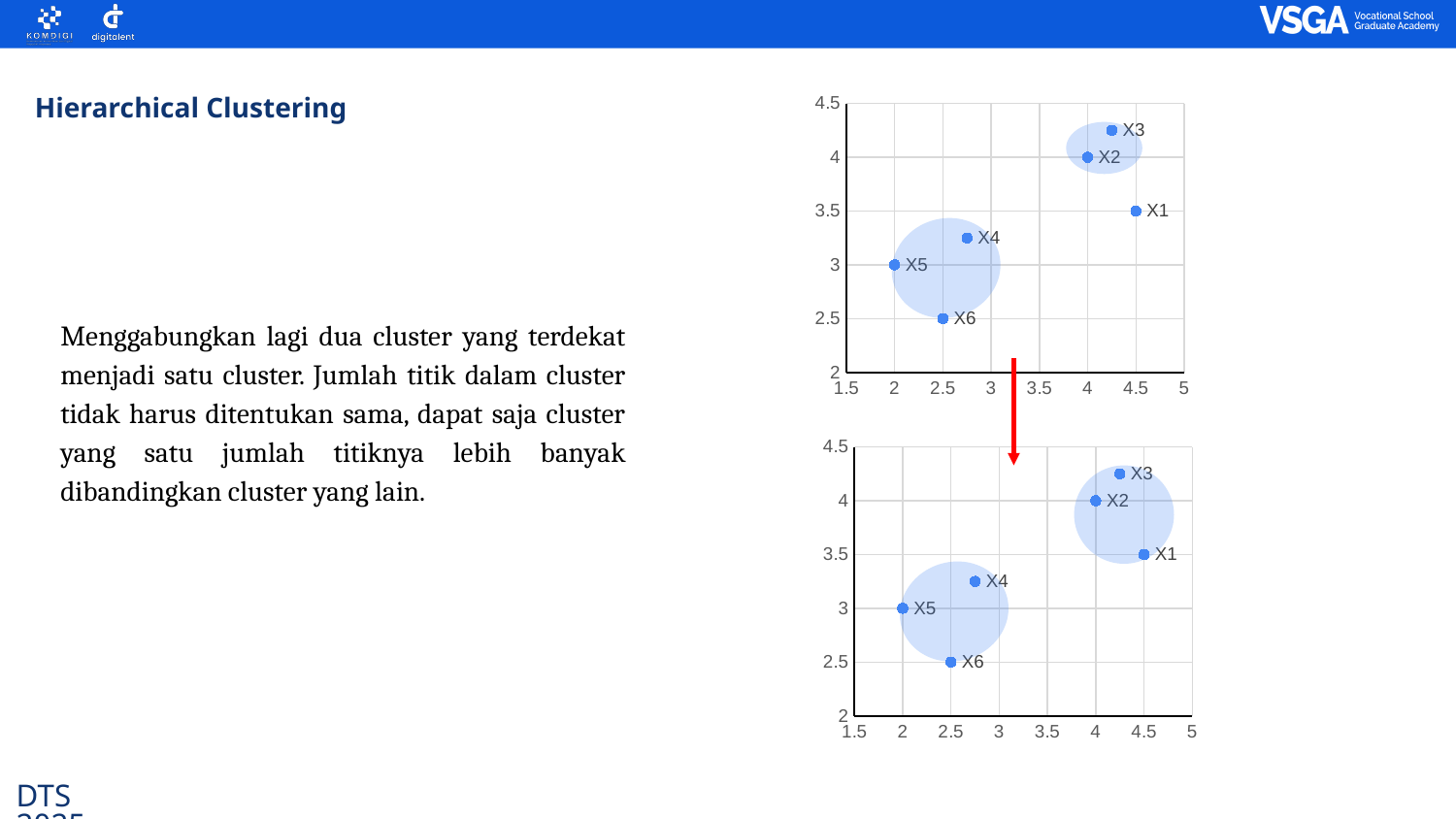
In the top chart, which point has the highest y-value? X3 In the bottom chart, which point has the lowest y-value? X6 What kind of chart is the top chart on the slide? scatter chart In the top chart, which point has a larger y-value, X1 or X2? X2 In the top chart, which point has the smallest x-value? X5 In the top chart, what is the y-value of point X5? 3 In the bottom chart, what is the x-value of point X2? 4 In the bottom chart, how many points are enclosed in the shaded cluster circle on the right? 3 How many data points are plotted in the bottom chart? 6 In the bottom chart, what is the x-value of point X1? 4.5 In the top chart, what is the y-value of point X6? 2.5 In the bottom chart, is the y-value of X4 greater or less than 3? greater